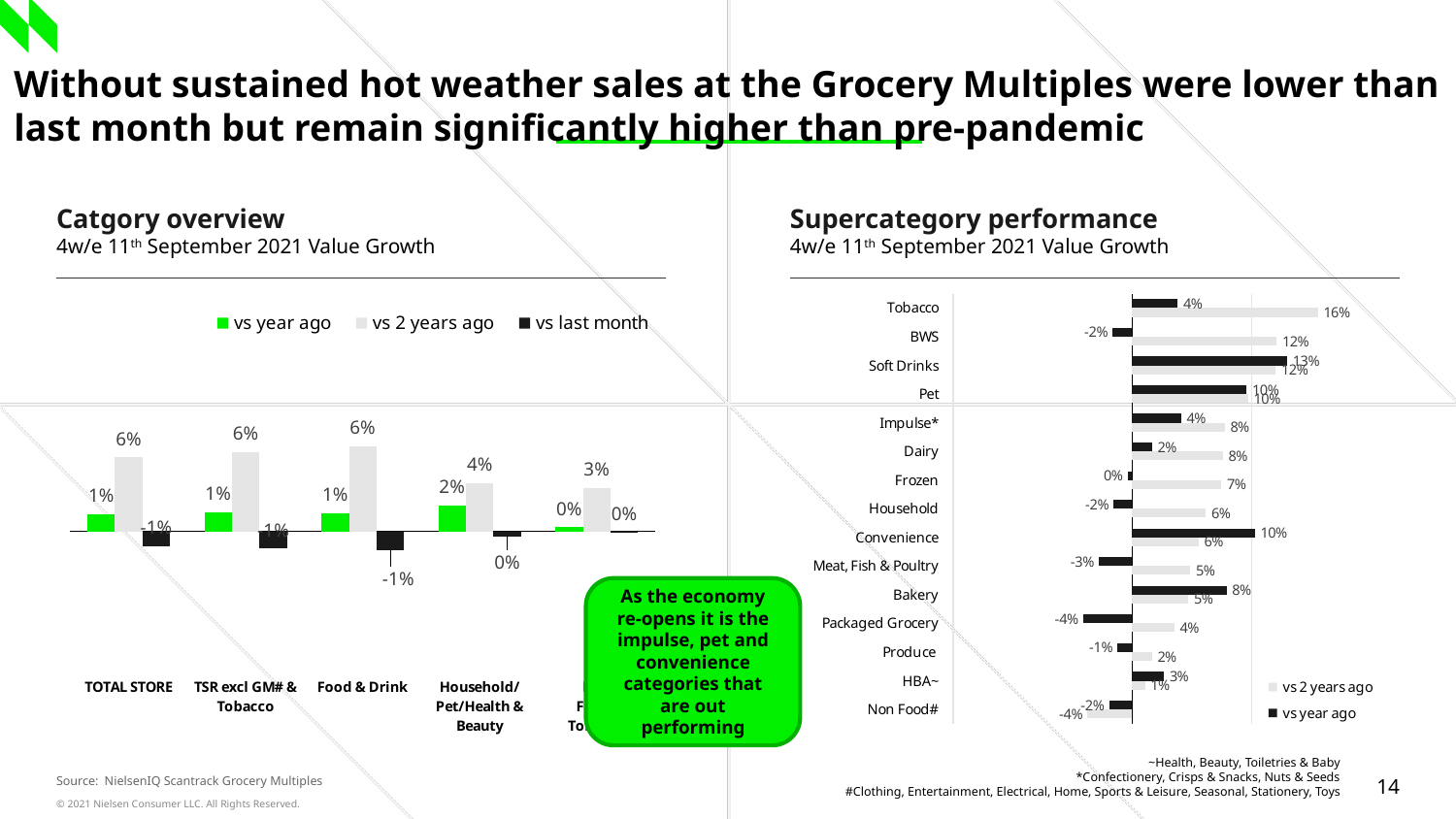
On the Supercategory performance chart, which supercategory has the highest vs 2 years ago value? Tobacco How many series does the legend of the Supercategory performance chart list? 2 On the Supercategory performance chart, what is the vs year ago value for Packaged Grocery? -4% On the Catgory overview chart, what is the vs 2 years ago value for TOTAL STORE? 6% On the Catgory overview chart, what is the vs year ago value for Household/Pet/Health & Beauty? 2% On the Supercategory performance chart, what is the vs 2 years ago value for Tobacco? 16% How many supercategories are shown on the Supercategory performance chart? 15 On the Supercategory performance chart, what is the difference between the vs 2 years ago and vs year ago values for BWS? 14 percentage points On the Supercategory performance chart, which supercategory has the lowest vs 2 years ago value? Non Food# How many series does the legend of the Catgory overview chart list? 3 What kind of chart is the Supercategory performance chart? Bar chart On the Supercategory performance chart, which is larger for Convenience: the vs year ago value or the vs 2 years ago value? vs year ago